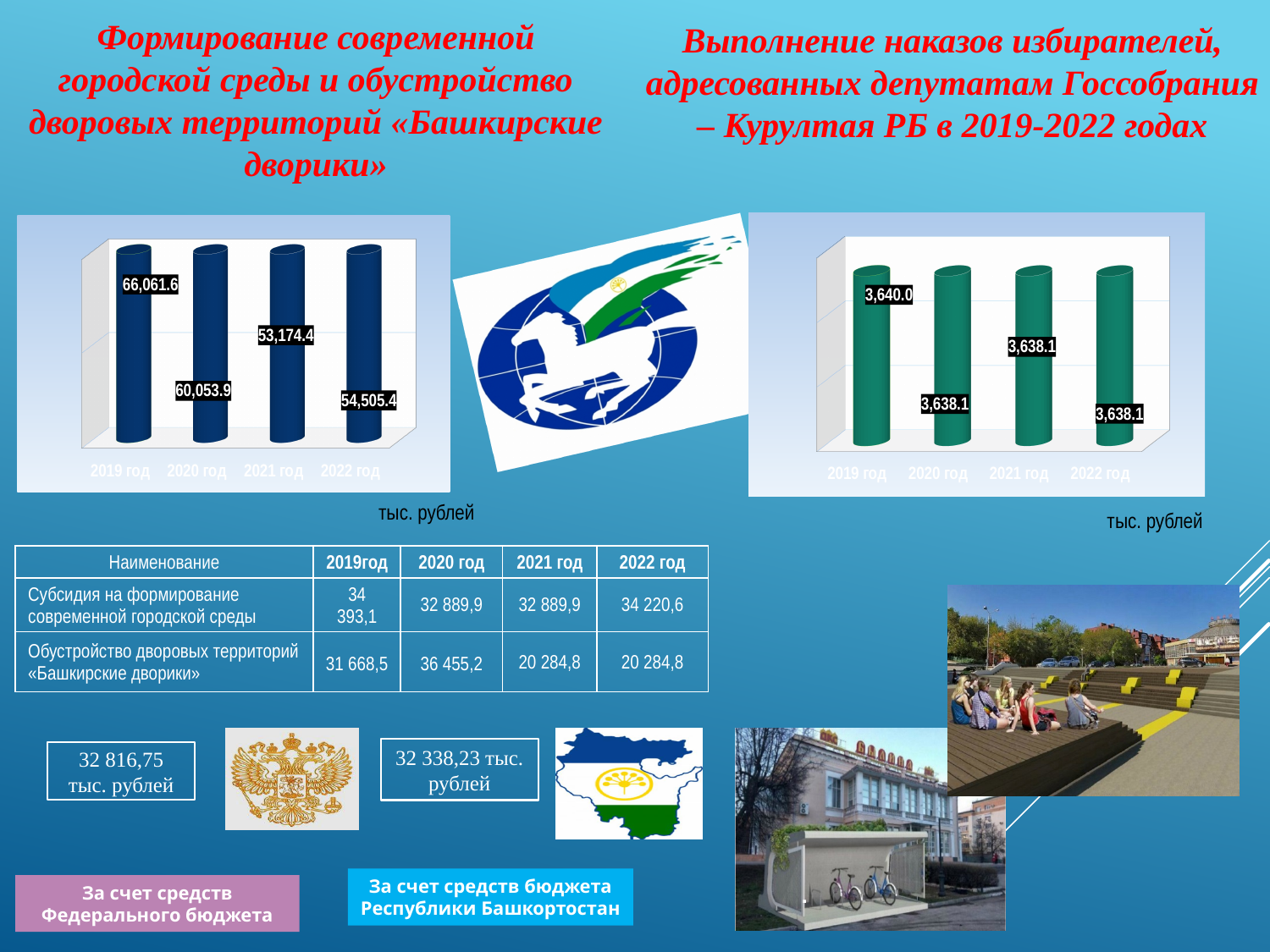
In the left chart (Формирование современной городской среды...), what is the value for 2019 год? 66,061.6 In the right chart (Выполнение наказов избирателей...), what is the value for 2019 год? 3,640.0 In the right chart (Выполнение наказов избирателей...), how many years are plotted? 4 In the right chart (Выполнение наказов избирателей...), which year has the highest value? 2019 год In the left chart (Формирование современной городской среды...), which year has the highest value? 2019 год In the left chart (Формирование современной городской среды...), which is larger, the value for 2021 год or 2022 год? 2022 год In the left chart (Формирование современной городской среды...), do the values rise or fall from 2019 год to 2021 год? fall In the right chart (Выполнение наказов избирателей...), what is the value for 2022 год? 3,638.1 In the left chart (Формирование современной городской среды...), what is the value for 2021 год? 53,174.4 What type of chart is the right chart (Выполнение наказов избирателей...)? bar chart In the left chart (Формирование современной городской среды...), what is the difference between the values for 2019 год and 2020 год? 6,007.7 In the left chart (Формирование современной городской среды...), which year has the lowest value? 2021 год